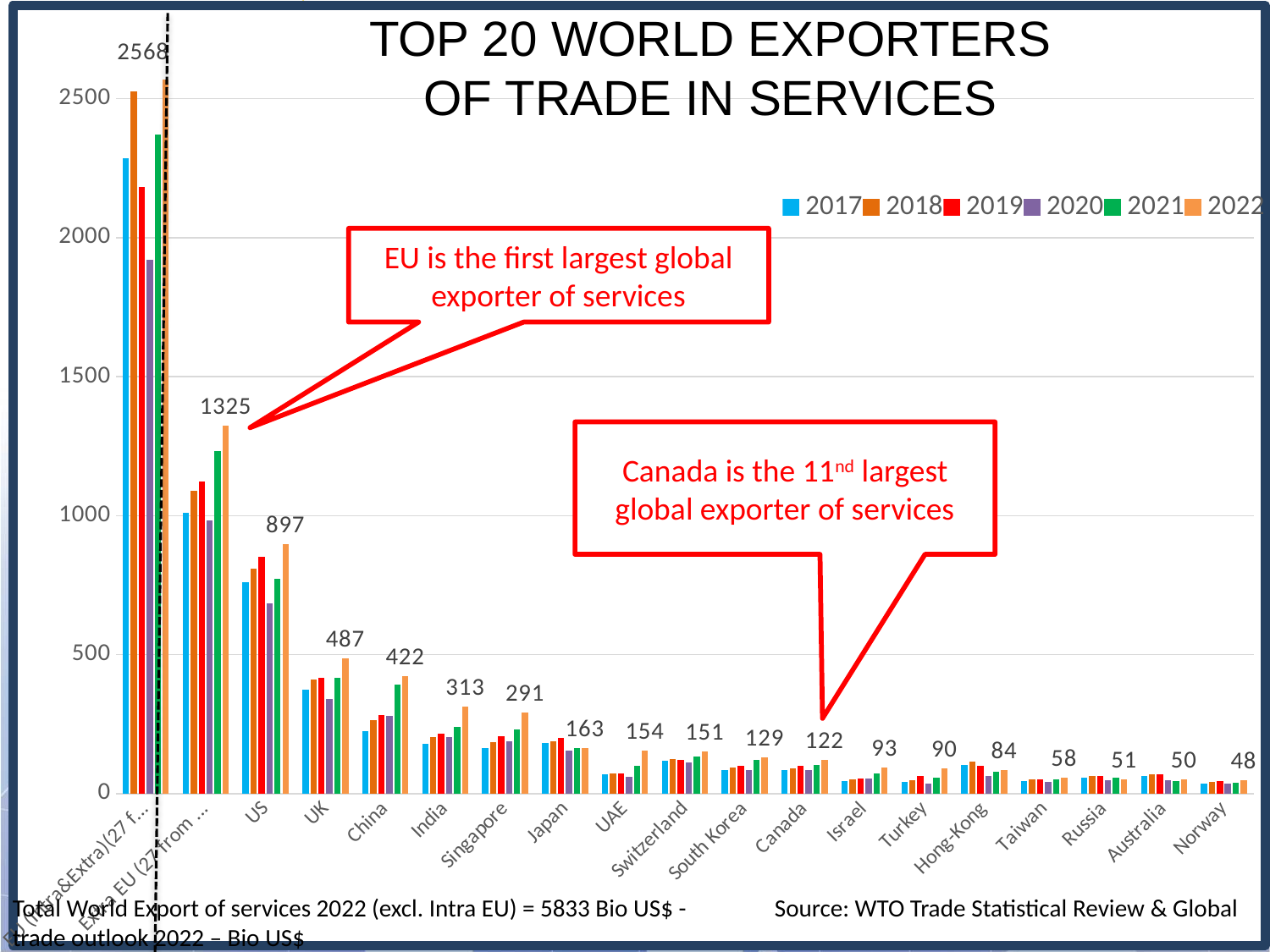
Is the 2021 value for China greater or less than 500? less What kind of chart is shown on the slide? bar chart What is the 2022 value labelled for Norway? 48 How many categories are shown on the x axis? 19 How many series does the legend list? 6 Which has the larger 2022 value, China or India? China Among the labelled 2022 values, which country has the lowest? Norway What is the 2022 value labelled for the US? 897 What is the 2022 value labelled for Canada? 122 Is the 2017 value for the US greater or less than 500? greater What is the difference between the 2022 labelled values for Taiwan and Russia? 7 What is the difference between the 2022 labelled values for the US and the UK? 410